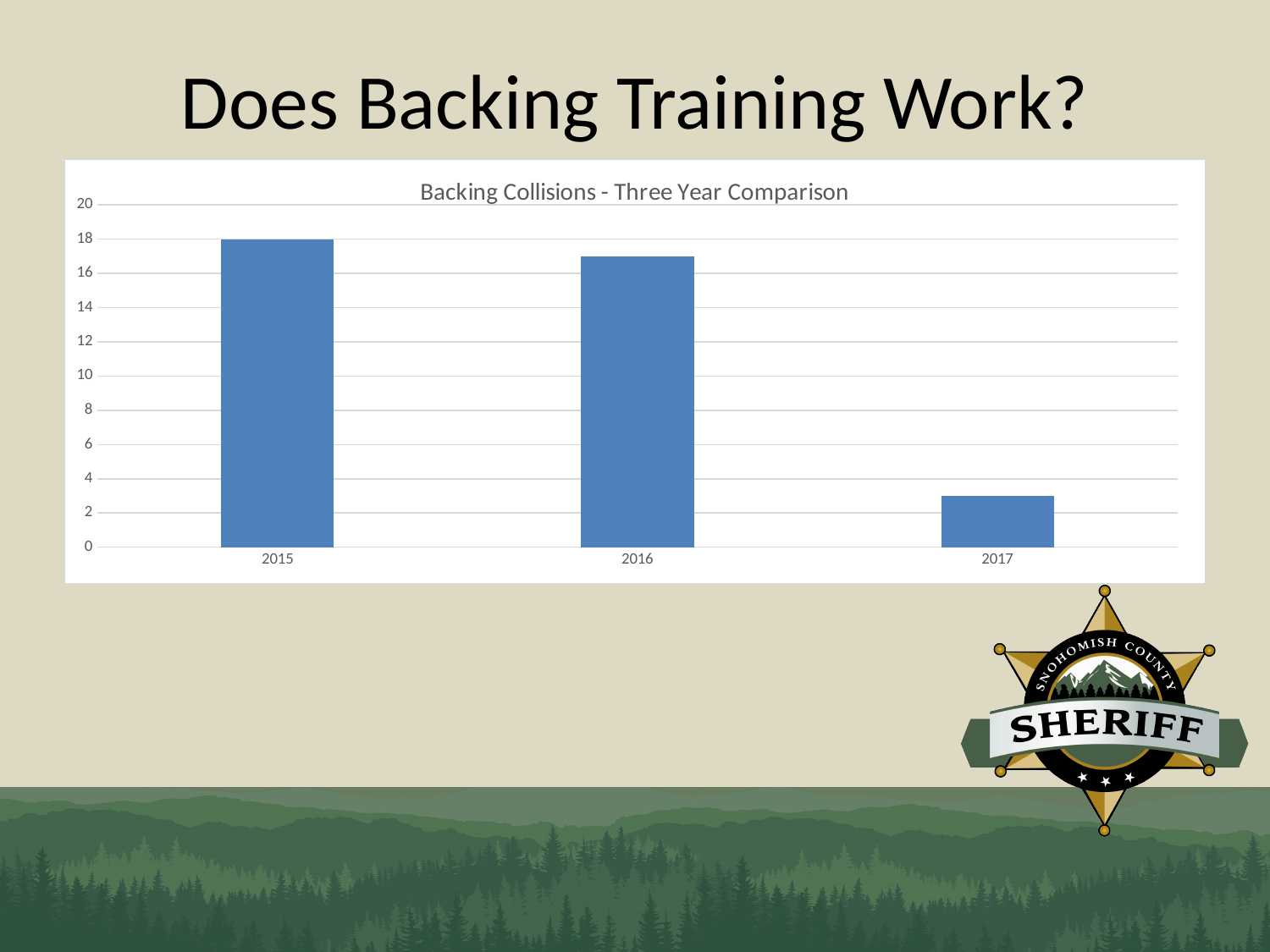
What colour are the bars in the chart? blue Which year has the highest number of backing collisions? 2015 Is the value for 2016 greater or less than 10? greater Which year has the lowest number of backing collisions? 2017 Do the values rise or fall from 2015 to 2017? fall Is the value for 2017 greater or less than 10? less What is the title of the chart? Backing Collisions - Three Year Comparison Is the value for 2017 greater or less than 4? less What is the value for 2015 in the chart? 18 Which year has a larger value, 2016 or 2017? 2016 What kind of chart is shown on the slide? bar chart How many years are shown on the x axis of the chart? 3